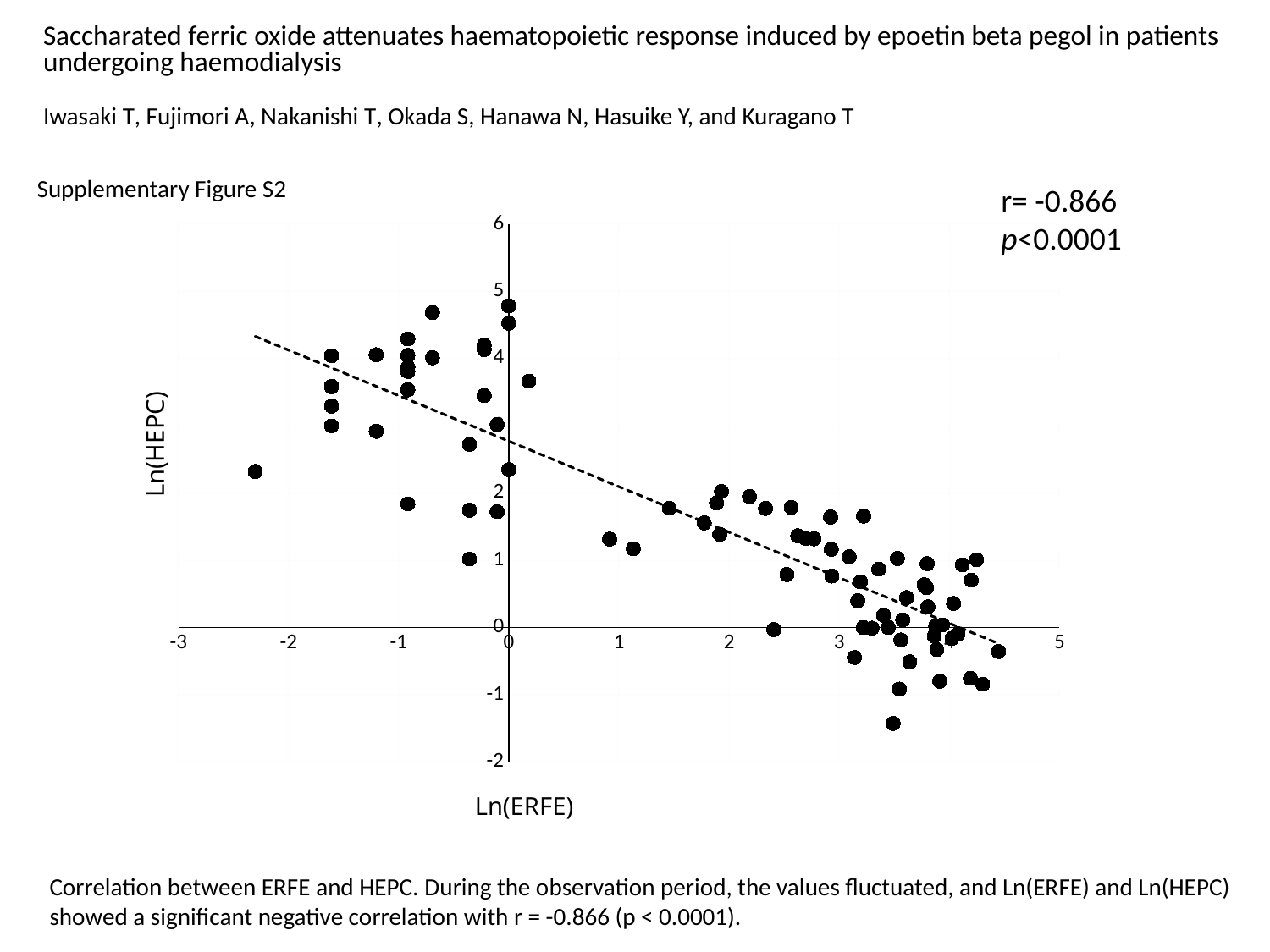
As Ln(ERFE) increases along the x axis, do the Ln(HEPC) values generally rise or fall? fall What kind of chart is shown in Supplementary Figure S2? scatter plot What is the label of the x axis of the chart? Ln(ERFE) What is the label of the y axis of the chart? Ln(HEPC) Is the highest Ln(HEPC) value plotted greater or less than 4? greater Is the smallest Ln(ERFE) value plotted greater or less than -2? less What is the minimum value shown on the x axis of the chart? -3 Is the lowest Ln(HEPC) value plotted greater or less than -1? less What is the maximum value shown on the y axis of the chart? 6 What correlation coefficient r is reported on the chart? -0.866 What p-value is reported on the chart? p<0.0001